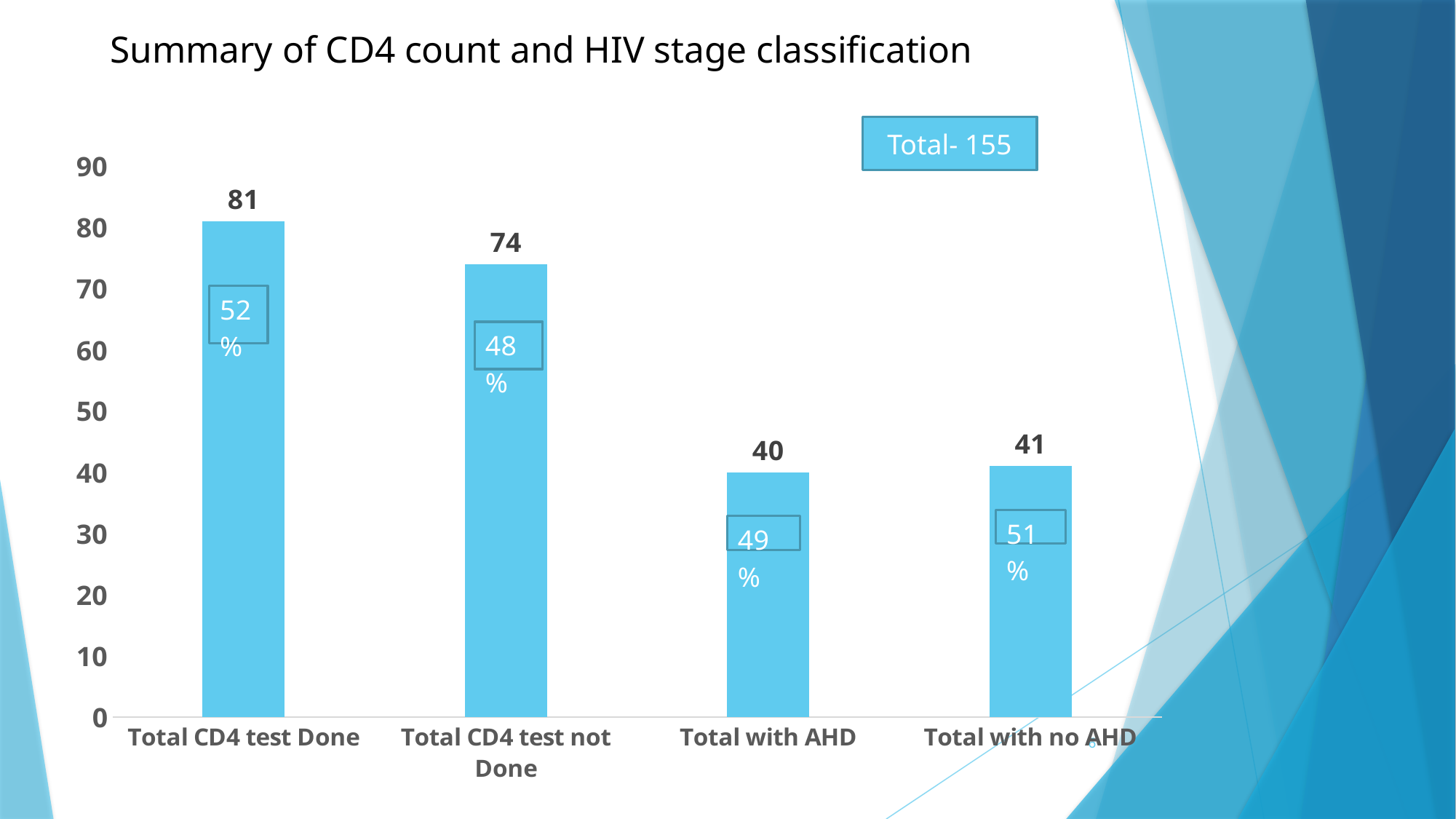
What is the difference between Total CD4 test Done and Total CD4 test not Done? 7 What is the value for Total CD4 test Done? 81 What kind of chart is shown on the slide? Bar chart What is the value for Total CD4 test not Done? 74 What total is shown in the box at the top right of the chart? Total- 155 What is the value for Total with no AHD? 41 What percentage label is shown on the Total with AHD bar? 49% Which category has the highest value? Total CD4 test Done Which category has the lowest value? Total with AHD What is the value for Total with AHD? 40 How many categories are shown on the chart? 4 Which is larger, Total CD4 test Done or Total CD4 test not Done? Total CD4 test Done